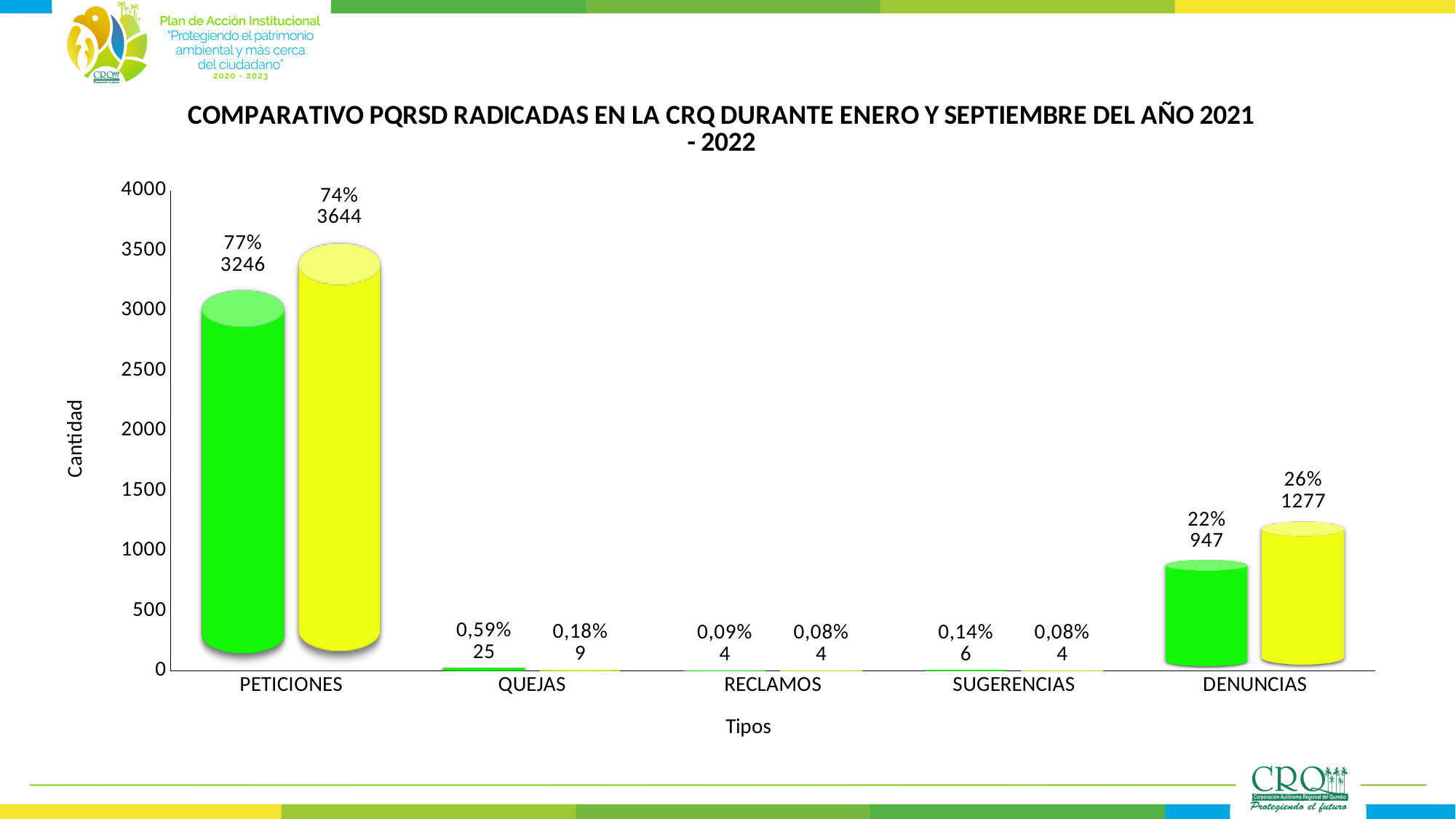
What is the value of the green bar for PETICIONES? 3246 What percentage is shown above the green bar for DENUNCIAS? 22% Which category has the highest values in the chart? PETICIONES What is the value of the green bar for QUEJAS? 25 How many categories are shown on the x axis? 5 What is the value of the yellow bar for DENUNCIAS? 1277 Which category has the lowest value for the green bars? RECLAMOS What is the value of the yellow bar for PETICIONES? 3644 For QUEJAS, which bar is larger, the green one or the yellow one? green What is the difference between the yellow bar and the green bar for PETICIONES? 398 What is the difference between the yellow bar and the green bar for DENUNCIAS? 330 What type of chart is shown on the slide? bar chart